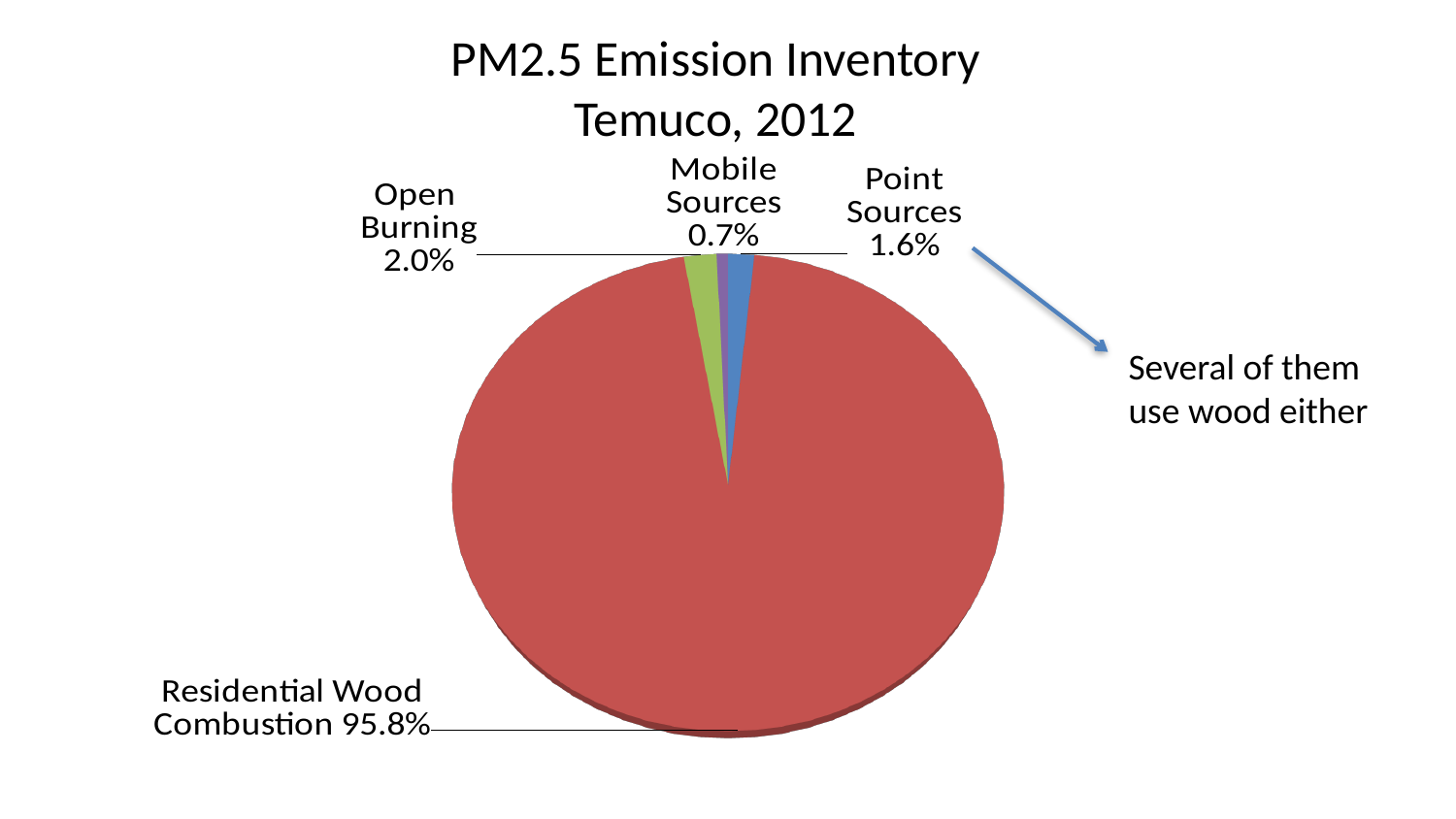
What share of PM2.5 emissions comes from Mobile Sources? 0.7% What colour is the Residential Wood Combustion slice? red What is the difference in share between Open Burning and Mobile Sources? 1.3% What share of PM2.5 emissions comes from Point Sources? 1.6% How many source categories are shown in the pie chart? 4 What share of PM2.5 emissions comes from Residential Wood Combustion? 95.8% What kind of chart is shown on the slide? pie chart Which source has the smallest share of PM2.5 emissions? Mobile Sources What is the title of the chart? PM2.5 Emission Inventory Temuco, 2012 Which source has the largest share of PM2.5 emissions? Residential Wood Combustion Which has a larger share, Open Burning or Point Sources? Open Burning